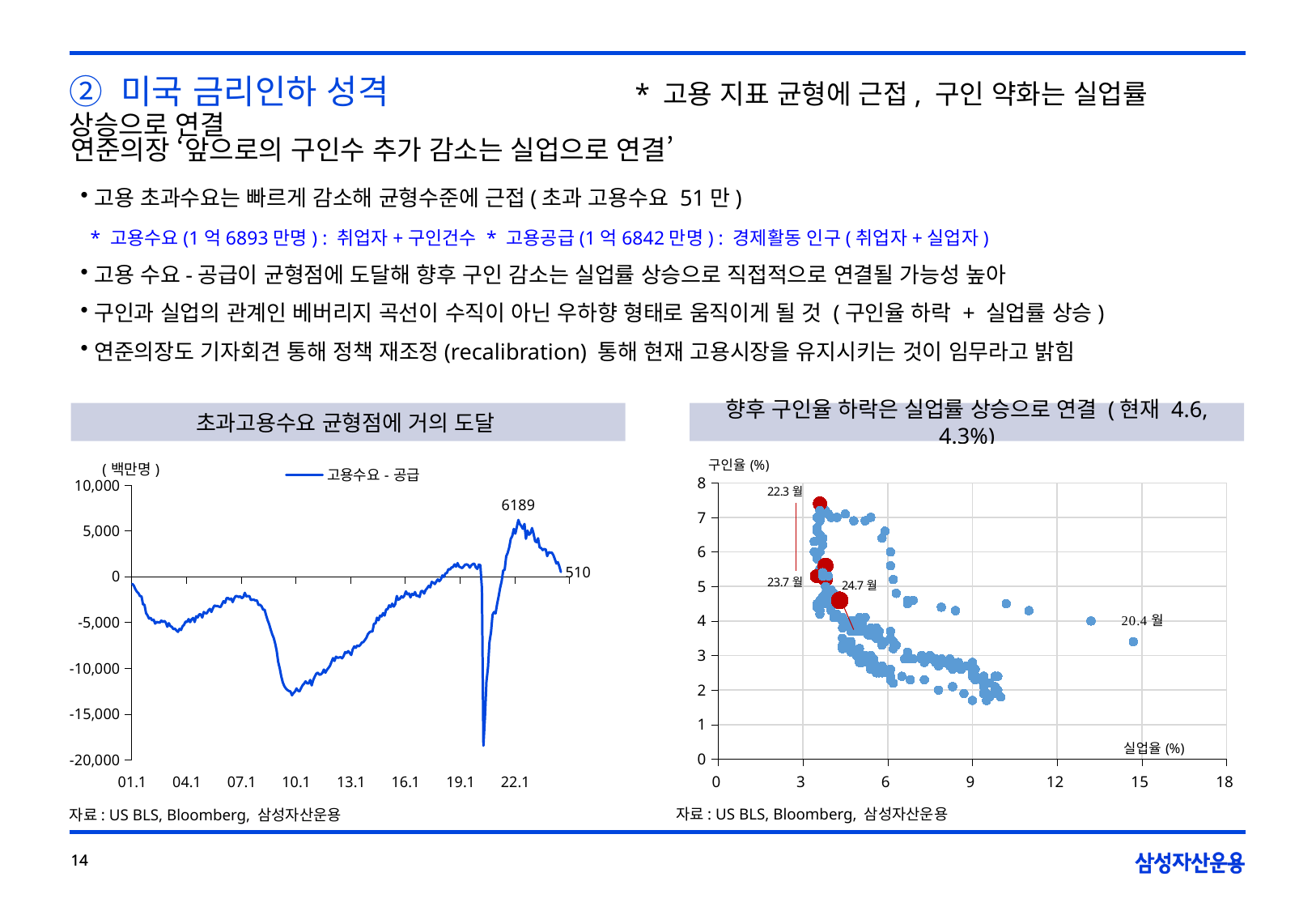
What kind of chart is the left chart titled '초과고용수요 균형점에 거의 도달'? line chart How many tick labels are shown on the x axis of the left chart? 8 On the left chart, what is the latest value labeled at the end of the 고용수요 - 공급 line? 510 On the left chart, what is the difference between the labeled peak value 6189 and the latest labeled value 510? 5679 How many series does the legend of the left chart list? 1 On the right chart, is the 구인율 value of the point labeled 22.3월 greater or less than 7? greater What is the label of the vertical axis on the right chart? 구인율 (%) On the left chart, is the lowest value of the 고용수요 - 공급 line greater or less than -15,000? less What is the name of the series shown in the legend of the left chart? 고용수요 - 공급 On the left chart, what is the peak value labeled on the 고용수요 - 공급 line? 6189 On the right chart, is the 실업율 value of the point labeled 20.4월 greater or less than 12? greater What kind of chart is the right chart titled '향후 구인율 하락은 실업률 상승으로 연결'? scatter chart